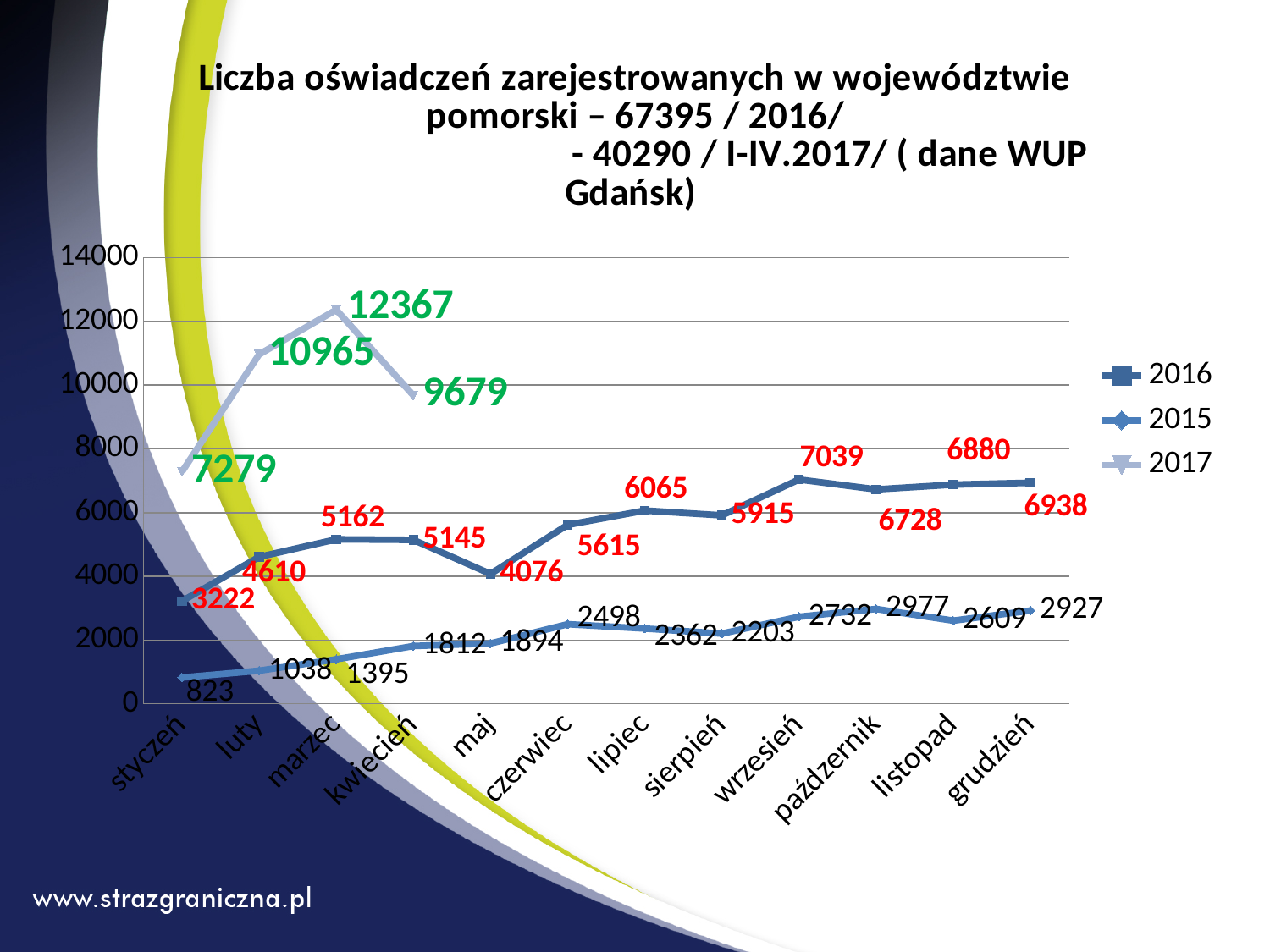
What type of chart is shown on the slide? line chart In which month does the 2015 series have its lowest value? styczeń In which month does the 2016 series reach its highest value? wrzesień Does the 2017 series rise or fall from marzec to kwiecień? fall What is the value for the 2015 series in styczeń? 823 How many series does the legend list? 3 Which is larger: the 2016 value in maj or the 2016 value in czerwiec? czerwiec What is the value for the 2017 series in marzec? 12367 How many months are shown on the x axis? 12 What is the difference between the 2016 and 2015 values in grudzień? 4011 What is the value for the 2016 series in wrzesień? 7039 What is the difference between the 2017 values in luty and styczeń? 3686